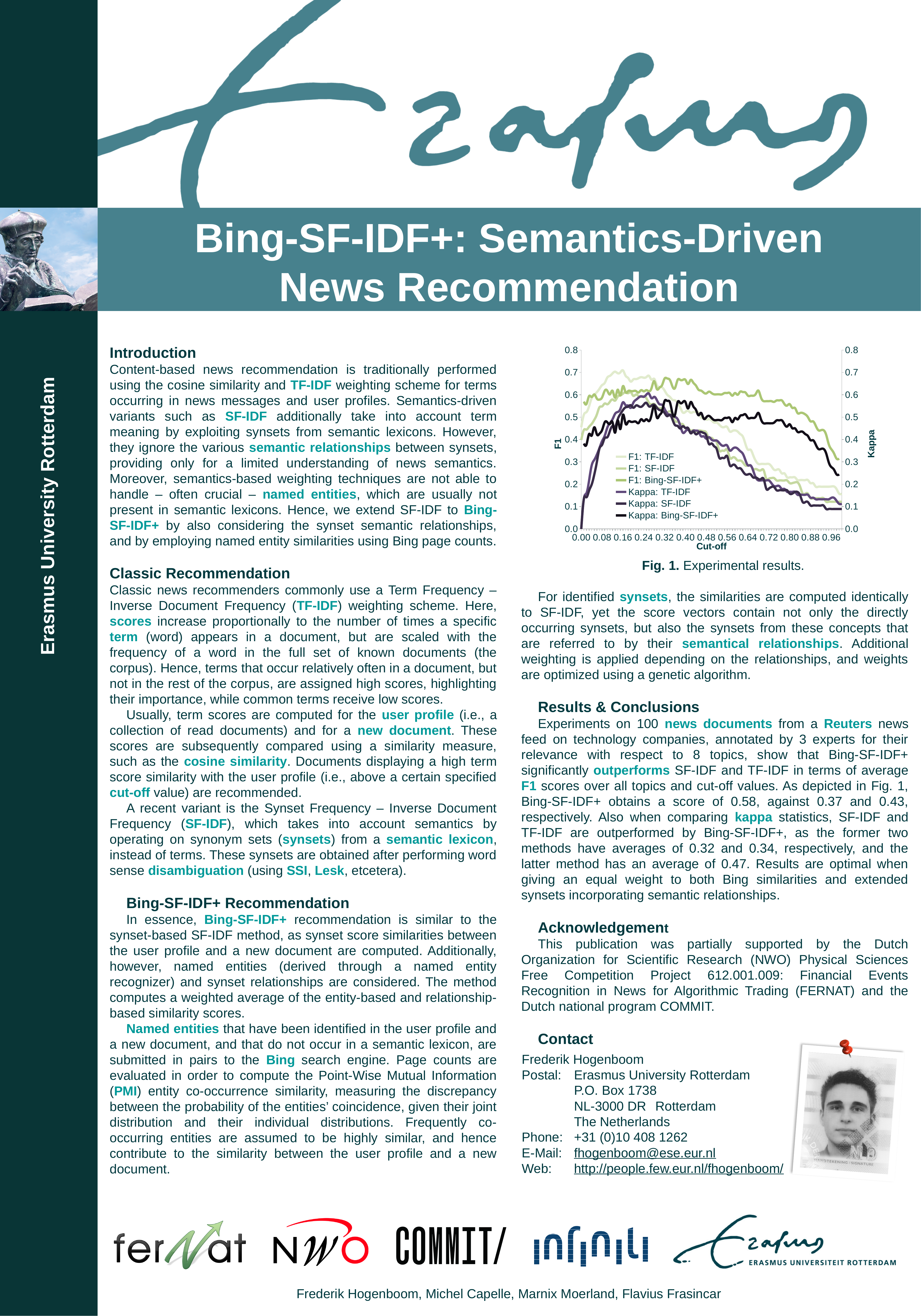
In the Fig. 1 chart, does the F1: TF-IDF line rise or fall between cut-off 0.48 and cut-off 0.96? fall In the Fig. 1 chart, is the value of Kappa: TF-IDF at cut-off 0.96 greater or less than 0.2? less In the Fig. 1 chart, at cut-off 0.80, which is larger: F1: Bing-SF-IDF+ or F1: TF-IDF? F1: Bing-SF-IDF+ What is the maximum value shown on the left y axis of the Fig. 1 chart? 0.8 What is the label of the x axis of the Fig. 1 chart? Cut-off What is the label of the right-hand y axis of the Fig. 1 chart? Kappa In the Fig. 1 chart, is the value of F1: Bing-SF-IDF+ at cut-off 0.16 greater or less than 0.5? greater How many series does the legend of the Fig. 1 chart list? 6 In the Fig. 1 chart, is the value of Kappa: Bing-SF-IDF+ at cut-off 0.64 greater or less than 0.4? greater In the Fig. 1 chart, which of the three F1 series is highest at cut-off 0.80? F1: Bing-SF-IDF+ What kind of chart is shown in Fig. 1? line chart